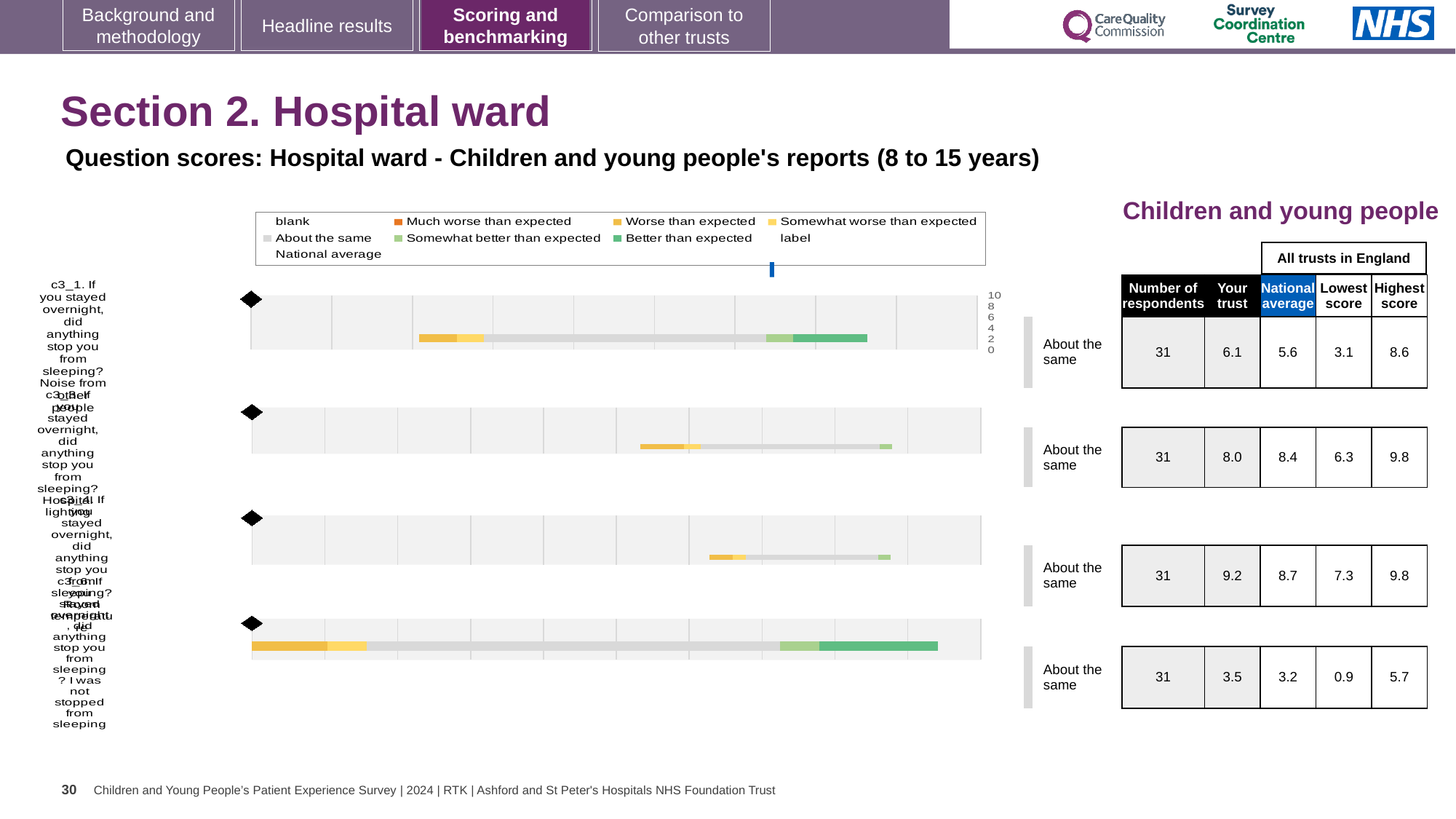
What benchmark category is printed beside each of the four charts? About the same In the table beside the bottom chart, what is the national average score? 3.2 How many separate bar charts (question rows) are shown on the slide? 4 For the top chart row, which is larger: the 'Your trust' score or the national average? Your trust In the chart legend, which colour represents 'Better than expected'? green Which of the four chart rows has the highest 'Your trust' score in the table? the third row (9.2) Which of the four chart rows has the lowest 'Your trust' score in the table? the bottom row (3.5) For the second chart row, which is larger: the 'Your trust' score (8.0) or the national average (8.4)? National average In the table beside the top chart (c3_1, noise from other people), what is the 'Your trust' score? 6.1 For the top chart row, what is the difference between the highest score (8.6) and the lowest score (3.1) in the table? 5.5 How many respondents are listed for each of the four chart rows? 31 What kind of chart is used to show the question scores on this slide? bar chart